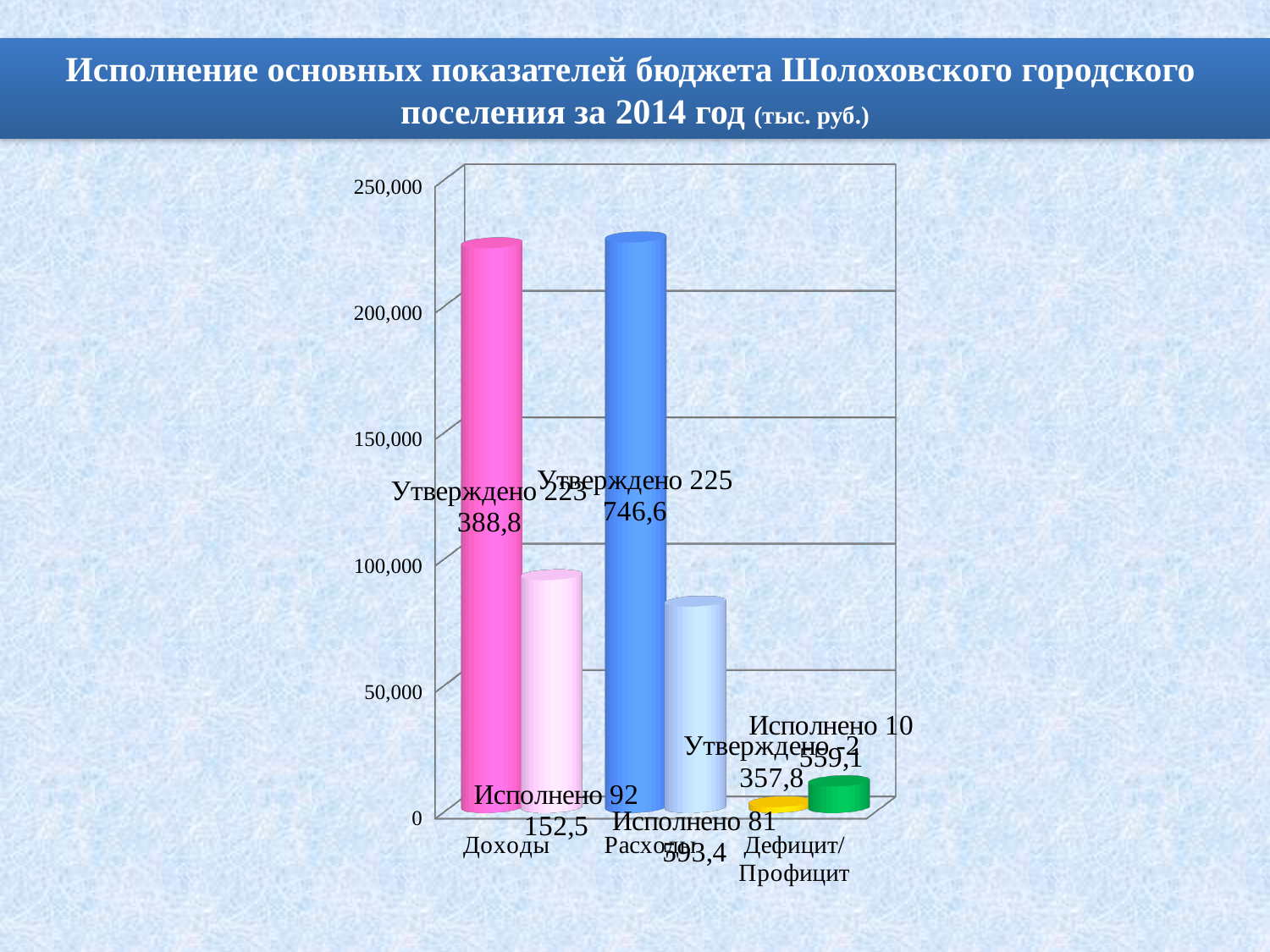
What is the approved (Утверждено) value for Расходы? 225 746,6 In what units are the values given according to the chart title? тыс. руб. Is the executed (Исполнено) bar for Доходы greater or less than 100,000 on the axis? less Which category has the lowest executed (Исполнено) value? Дефицит/Профицит What is the executed (Исполнено) value for Дефицит/Профицит? 10 559,1 Which is larger, the executed (Исполнено) value for Доходы or for Расходы? Доходы How many categories are shown along the x axis of the chart? 3 Which is larger, the approved (Утверждено) value for Доходы or for Расходы? Расходы What is the difference between the approved and executed values for Доходы? 131 236,3 What is the approved (Утверждено) value for Доходы? 223 388,8 What is the executed (Исполнено) value for Доходы? 92 152,5 What kind of chart is shown on the slide? bar chart